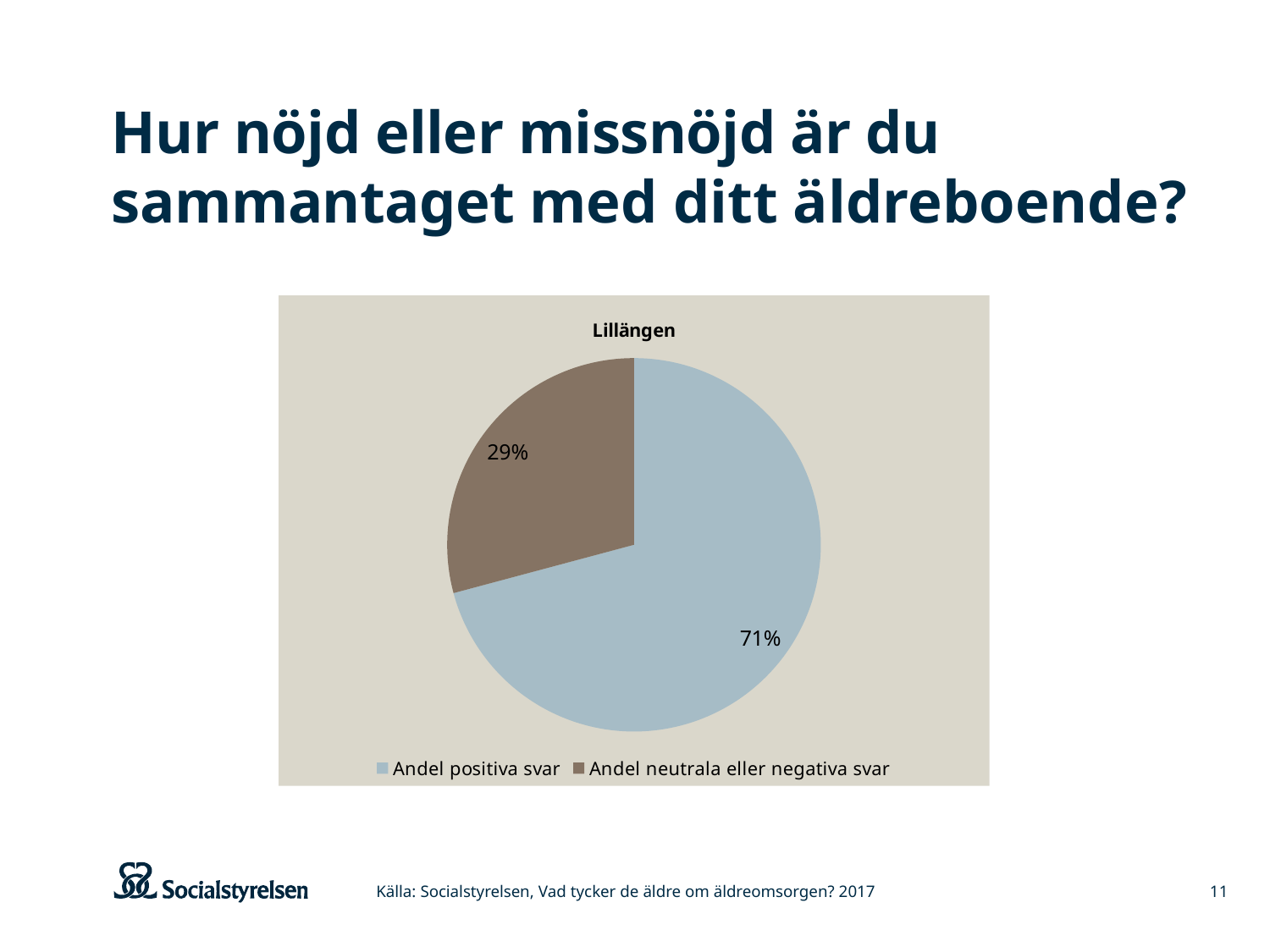
How many entries does the legend list? 2 What share of the pie is labelled "Andel positiva svar"? 71% Which legend entry is shown in brown? Andel neutrala eller negativa svar What is the difference in percentage points between the "Andel positiva svar" slice and the "Andel neutrala eller negativa svar" slice? 42 percentage points Which slice of the pie is the largest? Andel positiva svar What share of the pie is labelled "Andel neutrala eller negativa svar"? 29% Which slice of the pie is the smallest? Andel neutrala eller negativa svar Which is larger: the share for "Andel positiva svar" or the share for "Andel neutrala eller negativa svar"? Andel positiva svar What kind of chart is shown on the slide? Pie chart How many slices does the pie chart have? 2 What is the title of the chart? Lillängen